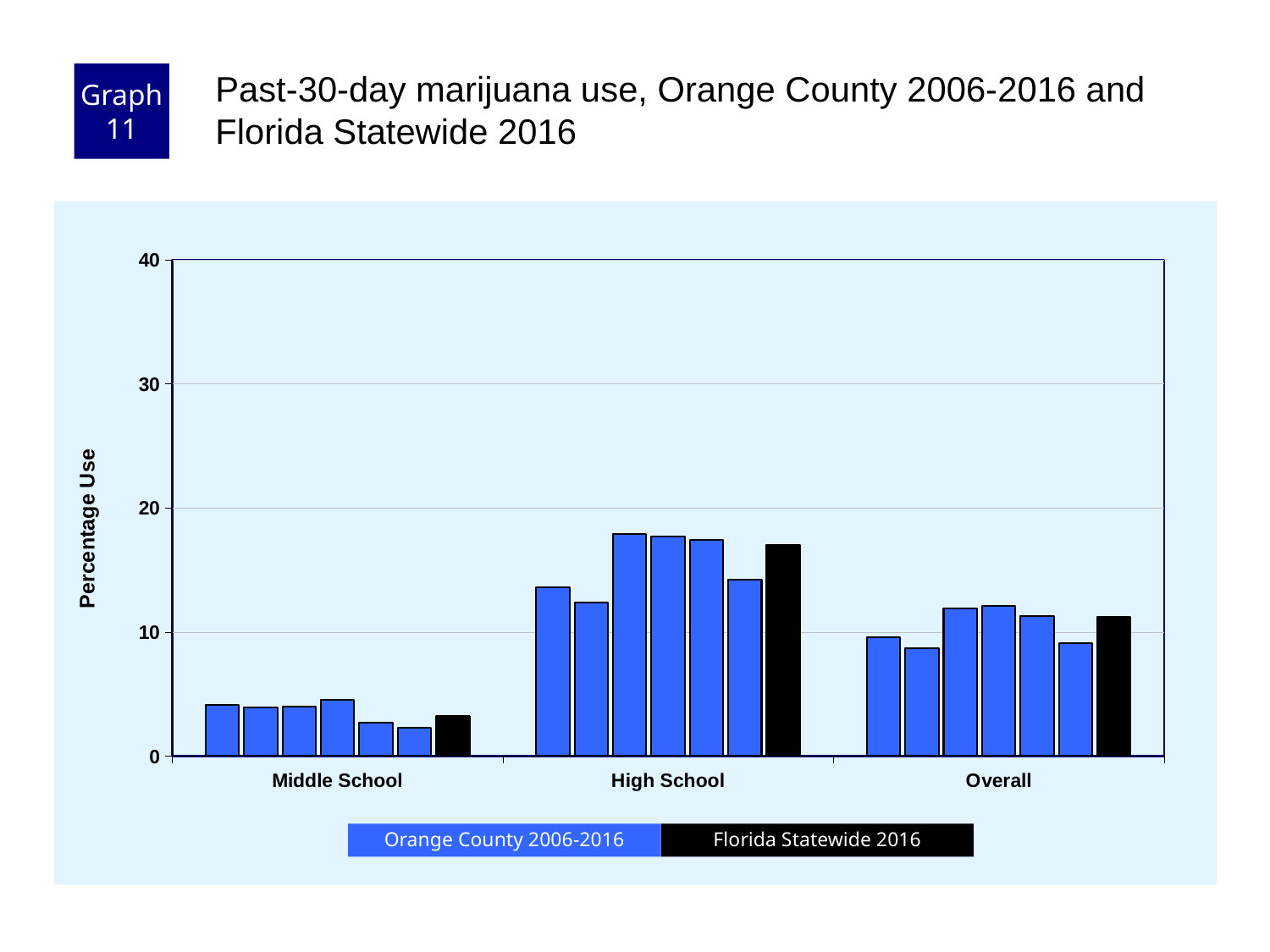
Which category has the highest bars in the chart? High School How many categories are shown on the x axis of the chart? 3 Are all the Orange County 2006-2016 bars for Middle School greater or less than 10? less Is the Florida Statewide 2016 value for High School greater or less than 10? greater Is the Florida Statewide 2016 value for High School greater or less than 20? less Which category has the lowest bars in the chart? Middle School What kind of chart is shown on the slide? bar chart Which is larger, the Florida Statewide 2016 value for High School or for Overall? High School What colour are the Florida Statewide 2016 bars in the chart? black How many series does the chart's legend list? 2 What is the label on the y axis of the chart? Percentage Use